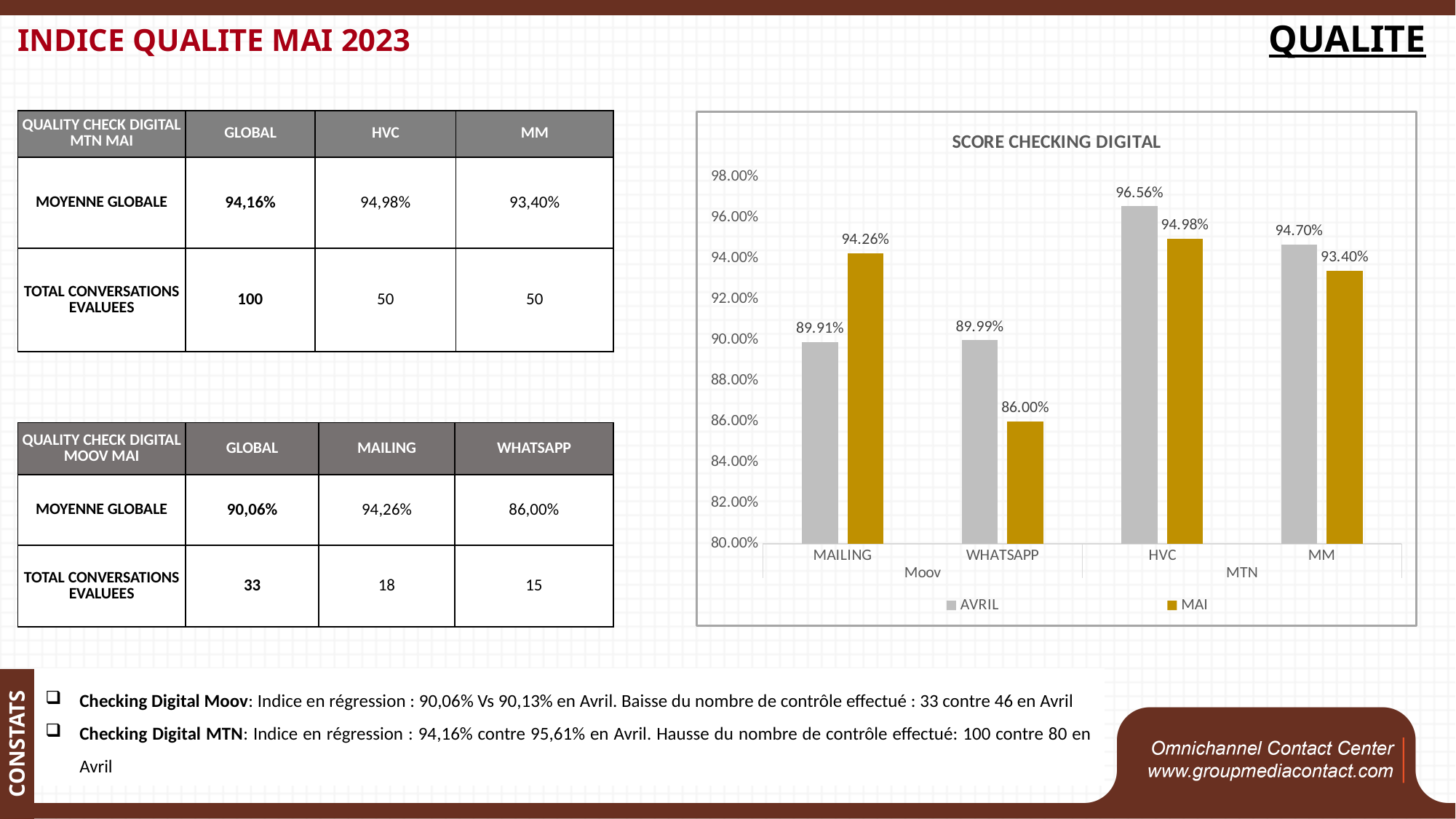
What is the MAI value for MM in the SCORE CHECKING DIGITAL chart? 93.40% Which colour represents the MAI series in the SCORE CHECKING DIGITAL chart? Gold What kind of chart is the SCORE CHECKING DIGITAL chart? Bar chart What is the MAI value for WHATSAPP in the SCORE CHECKING DIGITAL chart? 86.00% What is the AVRIL value for HVC in the SCORE CHECKING DIGITAL chart? 96.56% How many series does the legend of the SCORE CHECKING DIGITAL chart list? 2 Which category has the lowest MAI value in the SCORE CHECKING DIGITAL chart? WHATSAPP For HVC in the SCORE CHECKING DIGITAL chart, which is larger, the AVRIL value or the MAI value? AVRIL What is the difference between the MAI and AVRIL values for MAILING in the SCORE CHECKING DIGITAL chart? 4.35% Which category has the highest AVRIL value in the SCORE CHECKING DIGITAL chart? HVC What is the AVRIL value for MAILING in the SCORE CHECKING DIGITAL chart? 89.91% How many categories are shown on the x axis of the SCORE CHECKING DIGITAL chart? 4